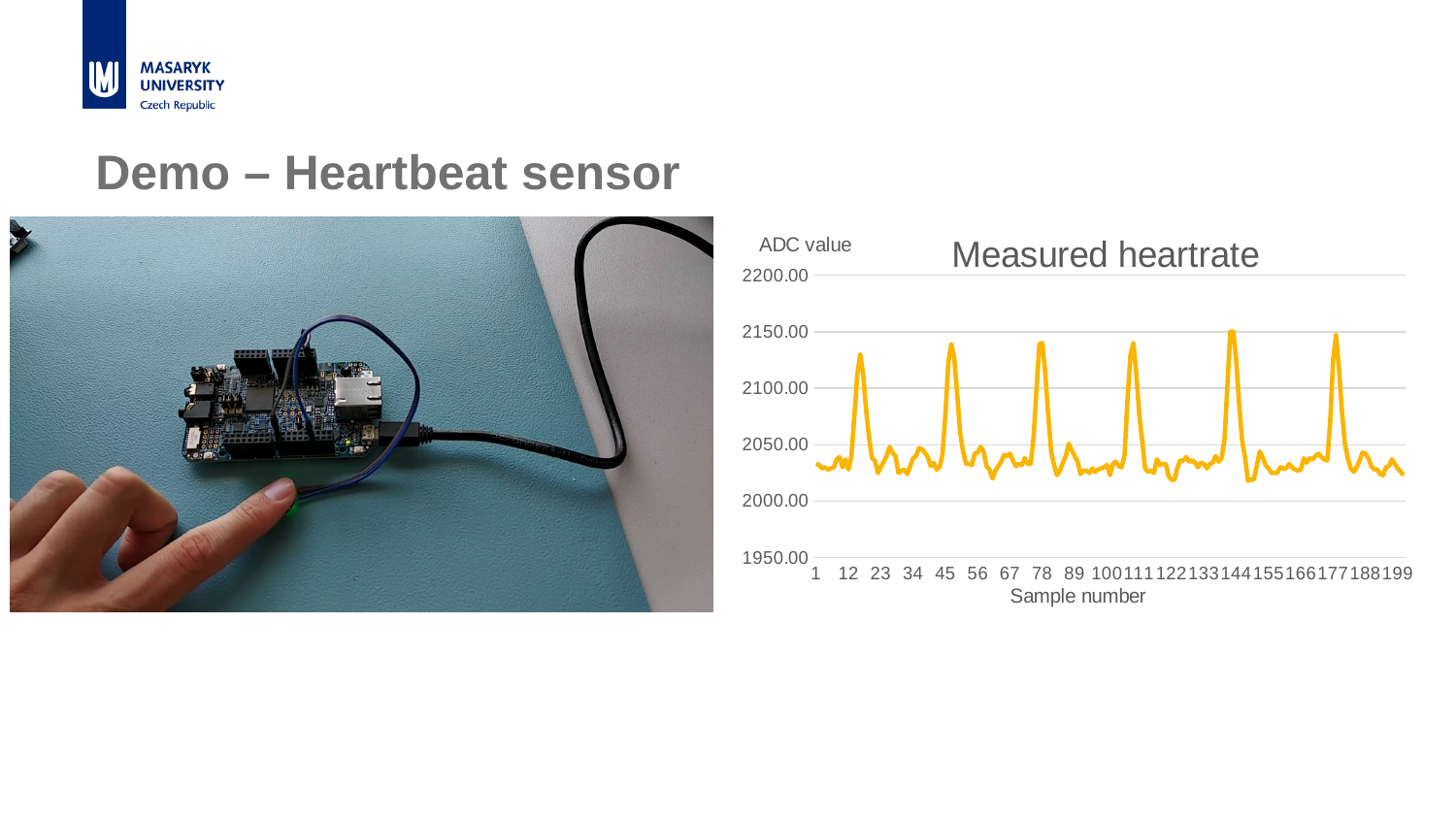
What is the title of the chart on the slide? Measured heartrate Is the ADC value at sample 1 greater or less than 2050? less Is the highest peak of the measured heartrate line greater or less than 2200? less How many distinct peaks above 2100 does the measured heartrate line show? 6 Is the highest peak of the measured heartrate line greater or less than 2100? greater What kind of chart is shown on the slide? line chart What label is given to the x axis of the chart? Sample number Does the measured heartrate line show a steady rise, a steady fall, or repeated spikes across the sample numbers? repeated spikes How many data series are plotted on the chart? 1